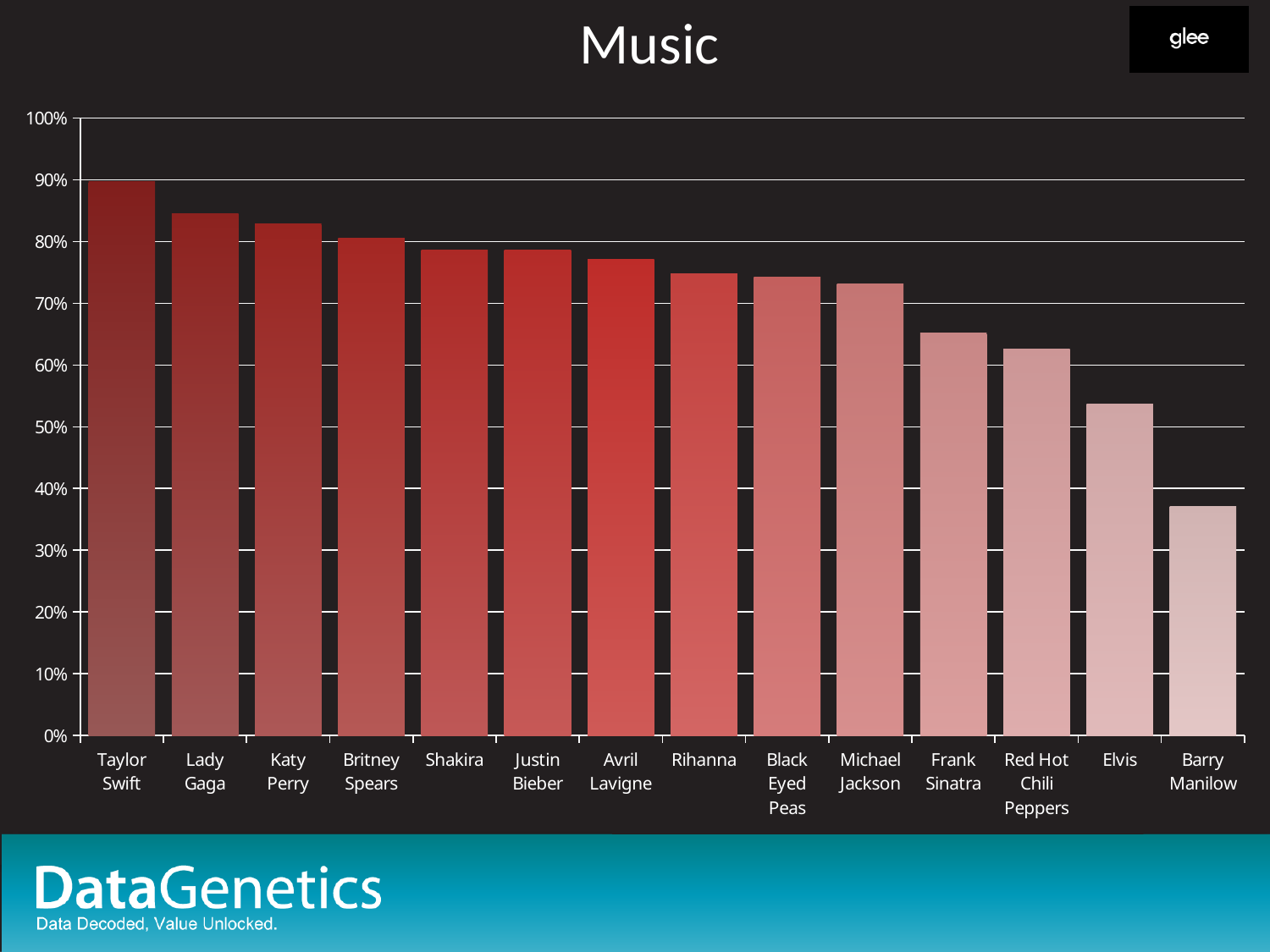
Is the value for Taylor Swift greater or less than 80%? greater How many artists are shown on the x axis of the chart? 14 What is the title of the chart? Music Is the value for Frank Sinatra greater or less than 70%? less Is the value for Michael Jackson greater or less than 70%? greater Which has a larger value, Lady Gaga or Rihanna? Lady Gaga Which artist has the lowest value in the chart? Barry Manilow Which artist has the highest value in the chart? Taylor Swift What type of chart is shown on the slide? bar chart Do the values rise or fall moving from left to right along the x axis? fall